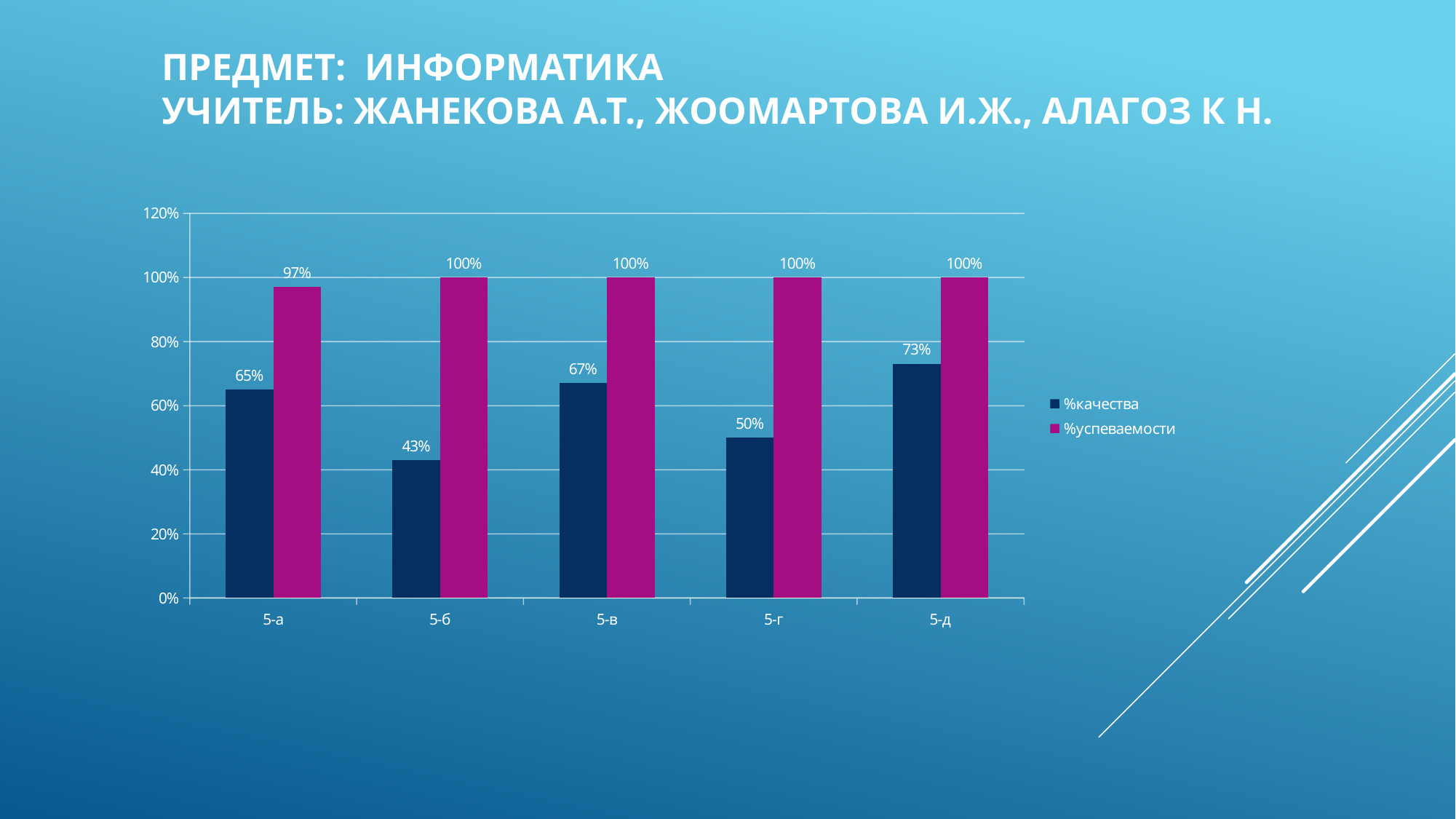
Which category has the lowest %качества value? 5-б What is the difference between the %качества values for 5-в and 5-б? 24% What is the %успеваемости value for 5-а? 97% What is the %качества value for 5-а? 65% Which is larger, the %качества value for 5-г or for 5-а? 5-а Which category has the lowest %успеваемости value? 5-а How many series does the legend list? 2 What colour are the %успеваемости bars? magenta How many categories are shown on the x axis? 5 What kind of chart is shown on the slide? bar chart Which category has the highest %качества value? 5-д What is the %качества value for 5-д? 73%